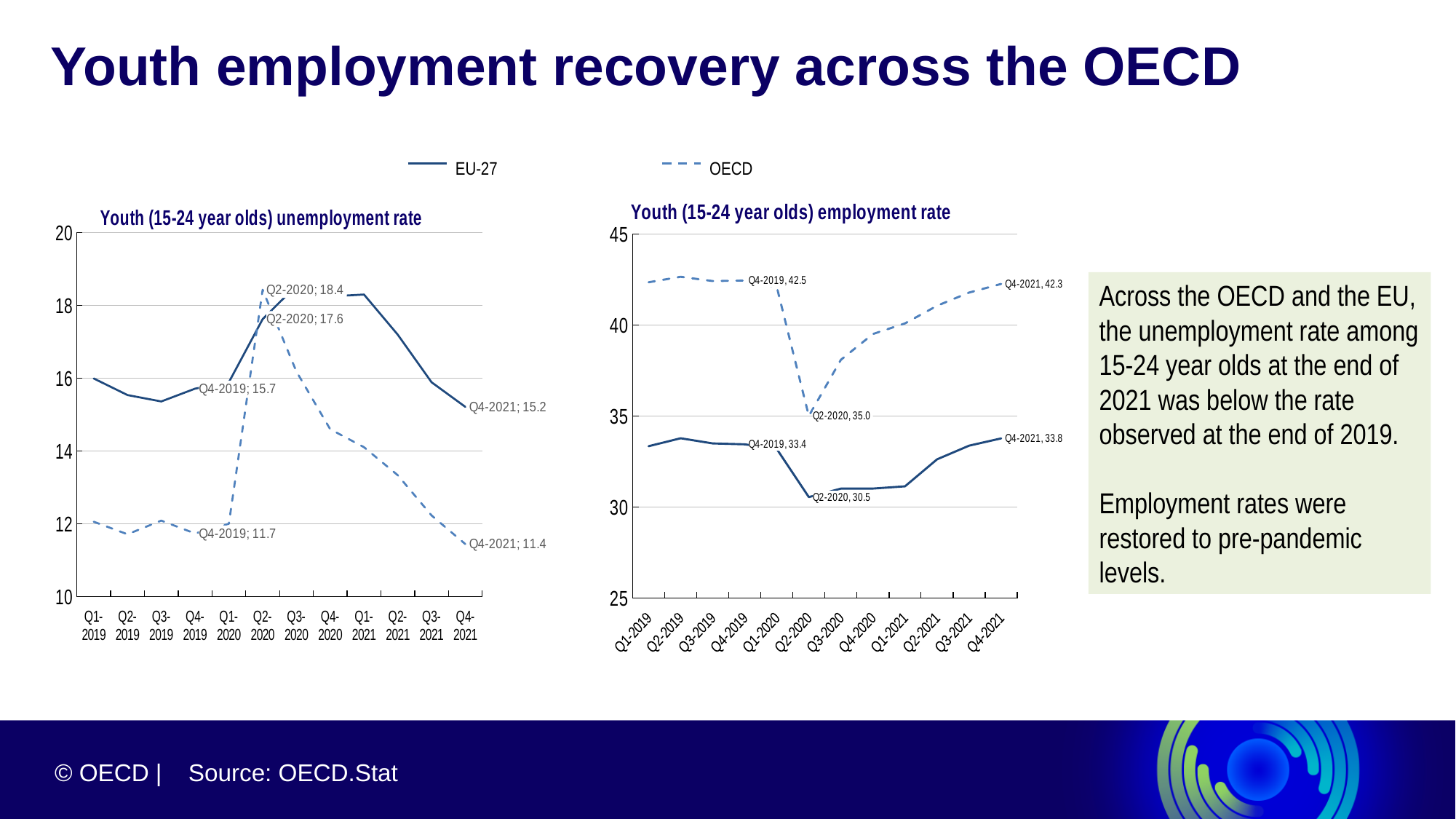
How many series does the legend list? 2 In the youth unemployment rate chart, how much did the EU-27 rate fall between Q4-2019 and Q4-2021? 0.5 In the youth unemployment rate chart, what was the EU-27 unemployment rate in Q4-2019? 15.7 In the youth employment rate chart, what was the EU-27 employment rate in Q4-2021? 33.8 In the youth employment rate chart, what was the OECD employment rate in Q2-2020? 35.0 In the youth employment rate chart, is the EU-27 value for Q1-2019 greater or less than 35? less In the youth unemployment rate chart, what was the OECD unemployment rate in Q4-2021? 11.4 In the youth unemployment rate chart, what was the OECD unemployment rate in Q2-2020? 18.4 In the youth unemployment rate chart, which series had the higher value in Q4-2021, EU-27 or OECD? EU-27 What type of chart is the youth unemployment rate chart? Line chart In the youth employment rate chart, what is the difference between the OECD employment rate in Q4-2019 and Q4-2021? 0.2 How many quarters are shown on the x axis of the youth employment rate chart? 12